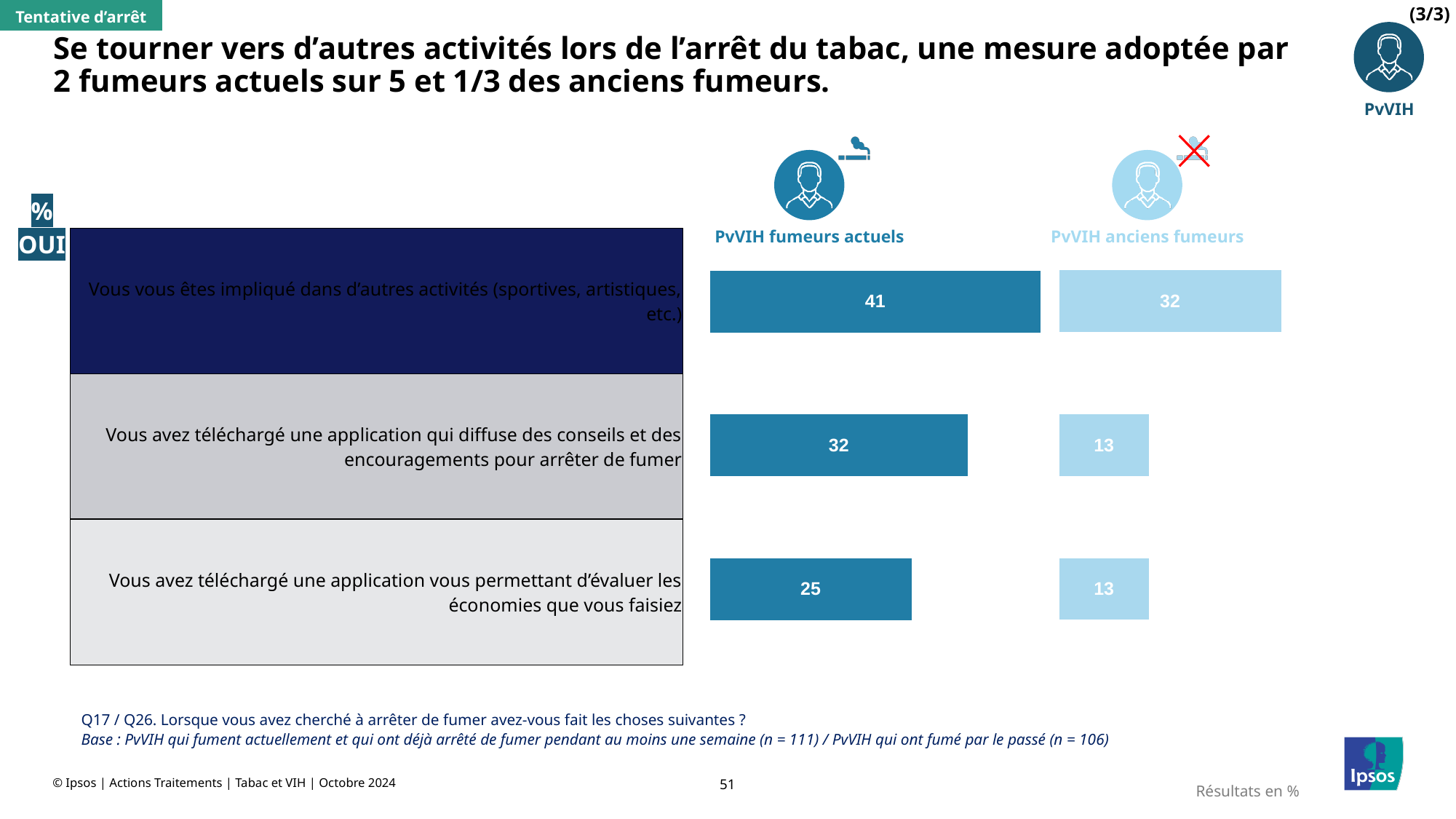
What is the value for "Vous vous êtes impliqué dans d'autres activités (sportives, artistiques, etc.)" among PvVIH anciens fumeurs? 32 Which item has the highest value among PvVIH fumeurs actuels? Vous vous êtes impliqué dans d'autres activités (sportives, artistiques, etc.) Which item has the lowest value among PvVIH fumeurs actuels? Vous avez téléchargé une application vous permettant d'évaluer les économies que vous faisiez How many items (categories) are shown in the chart? 3 What is the difference between PvVIH fumeurs actuels and PvVIH anciens fumeurs for "Vous avez téléchargé une application qui diffuse des conseils et des encouragements pour arrêter de fumer"? 19 Which group has the larger value for "Vous avez téléchargé une application vous permettant d'évaluer les économies que vous faisiez": PvVIH fumeurs actuels or PvVIH anciens fumeurs? PvVIH fumeurs actuels What is the difference between PvVIH fumeurs actuels and PvVIH anciens fumeurs for "Vous vous êtes impliqué dans d'autres activités (sportives, artistiques, etc.)"? 9 What is the value for "Vous avez téléchargé une application qui diffuse des conseils et des encouragements pour arrêter de fumer" among PvVIH fumeurs actuels? 32 What is the value for "Vous vous êtes impliqué dans d'autres activités (sportives, artistiques, etc.)" among PvVIH fumeurs actuels? 41 What is the value for "Vous avez téléchargé une application vous permettant d'évaluer les économies que vous faisiez" among PvVIH anciens fumeurs? 13 What type of chart is shown on the slide? Bar chart How many groups (series) are compared in the chart? 2